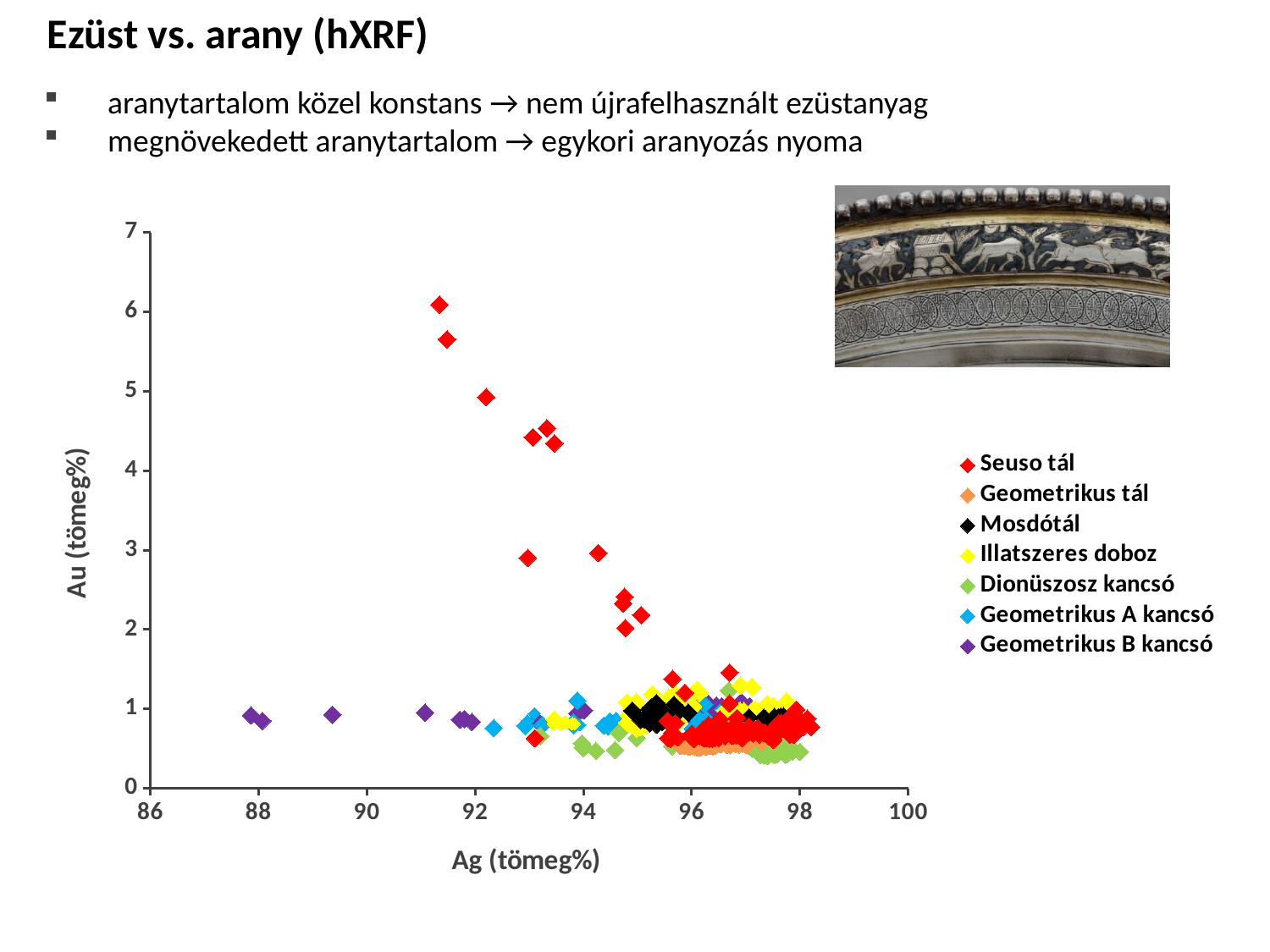
Which series has the higher maximum Au (tömeg%) value, Seuso tál or Dionüszosz kancsó? Seuso tál Is the Ag (tömeg%) value of the leftmost point on the chart greater or less than 90? less What kind of chart is shown on the slide? scatter chart Is the highest Au (tömeg%) value plotted on the chart greater or less than 5? greater What is the title of the x axis? Ag (tömeg%) Which series is plotted with green markers? Dionüszosz kancsó How many series does the legend list? 7 Is the highest Au (tömeg%) value for Geometrikus B kancsó greater or less than 2? less Which series contains the point with the highest Au (tömeg%) value? Seuso tál What is the highest value shown on the x axis? 100 Which series contains the points with the lowest Ag (tömeg%) values? Geometrikus B kancsó